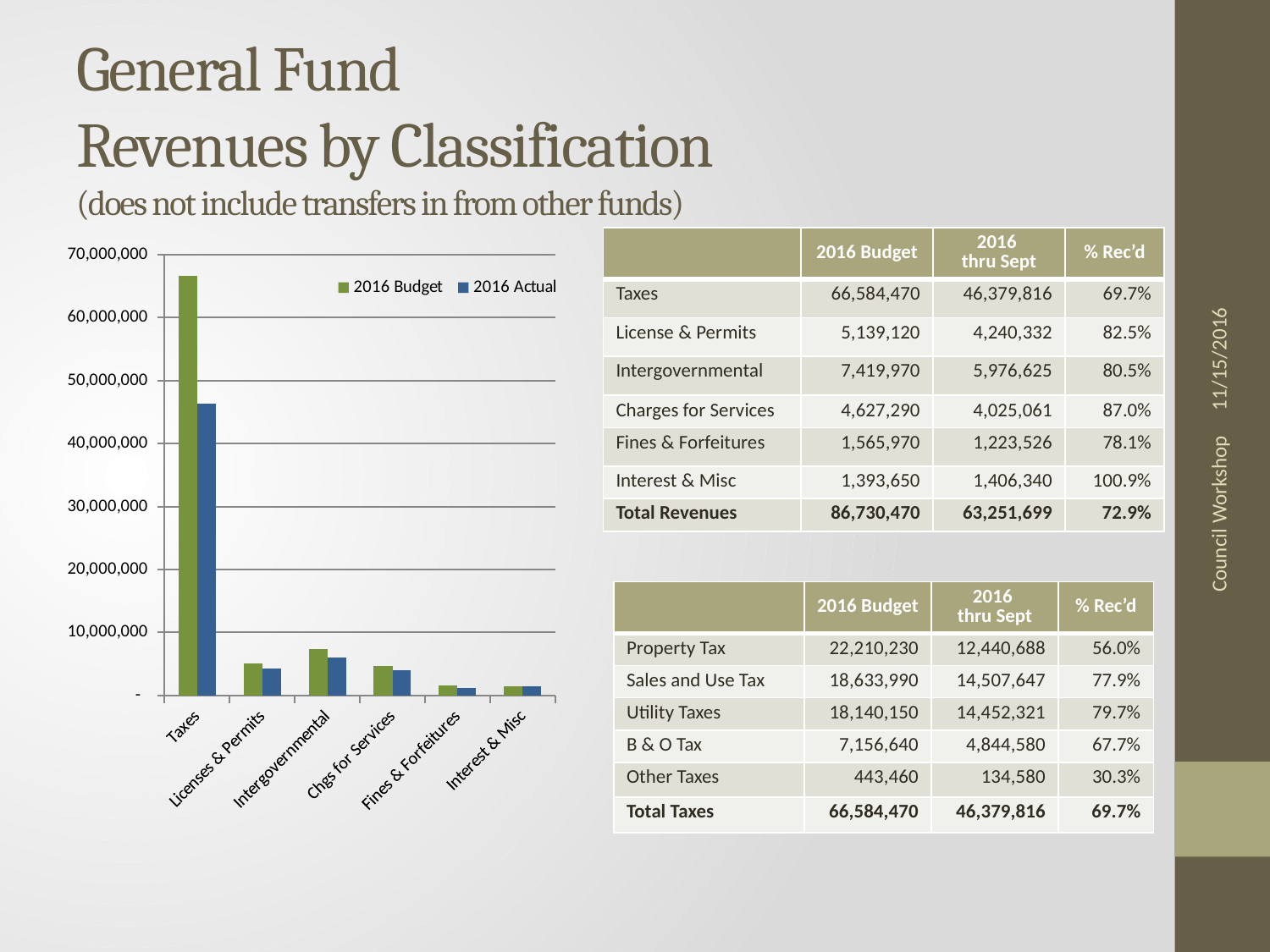
Which category has the highest 2016 Actual bar in the chart? Taxes What kind of chart is shown on the slide? bar chart Which category has the highest 2016 Budget bar in the chart? Taxes What is the highest value labelled on the chart's vertical axis? 70,000,000 In the chart, which category has the larger 2016 Budget bar: Intergovernmental or Licenses & Permits? Intergovernmental In the chart, which is larger for Taxes: the 2016 Budget bar or the 2016 Actual bar? 2016 Budget How many series does the chart legend list? 2 In the chart, is the 2016 Actual value for Taxes greater or less than 50,000,000? less In the chart, is the 2016 Budget value for Taxes greater or less than 60,000,000? greater What are the two series named in the chart legend? 2016 Budget and 2016 Actual In the chart, is the 2016 Budget value for Intergovernmental greater or less than 10,000,000? less How many revenue categories are plotted on the chart's x axis? 6